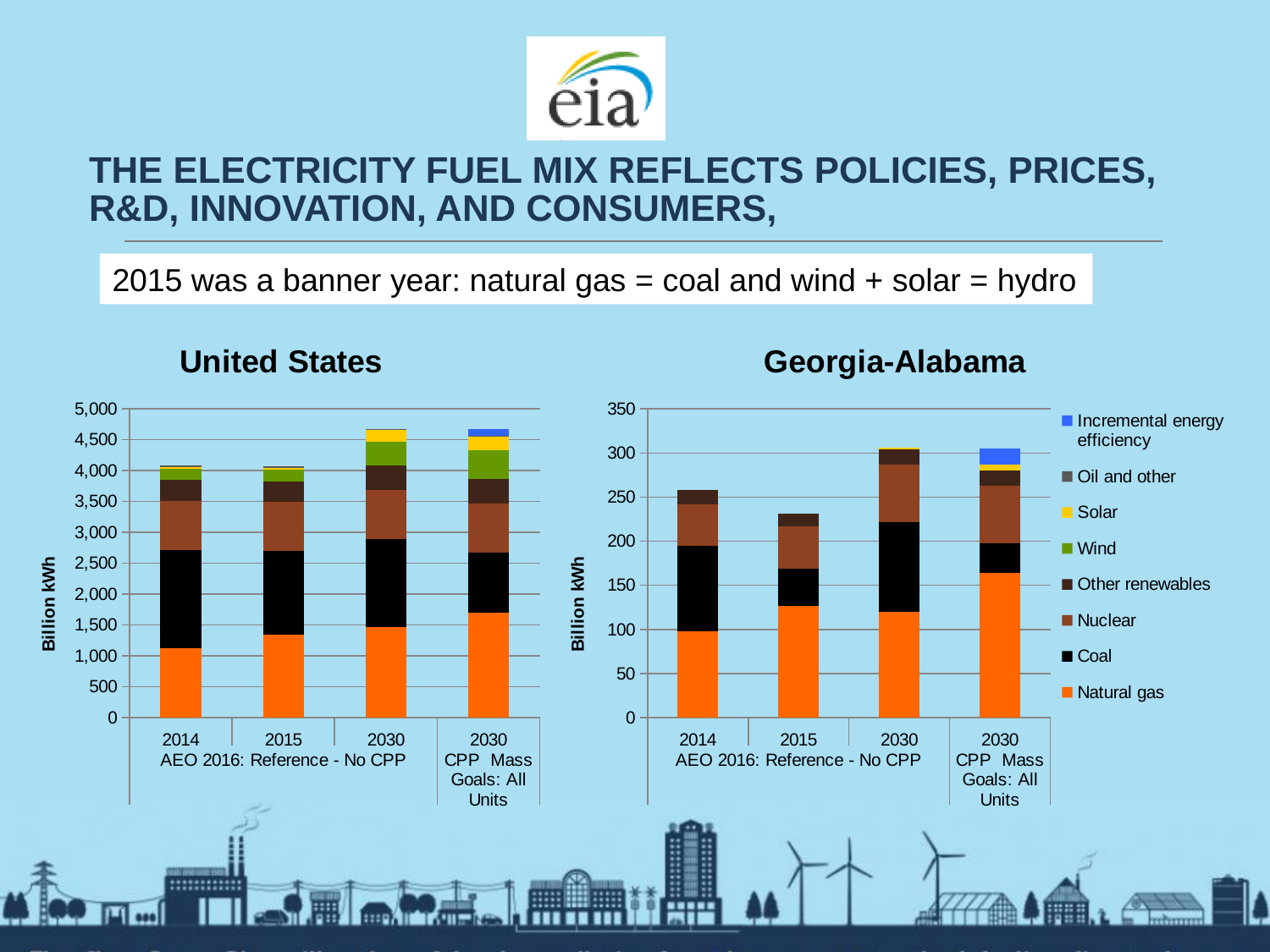
In the legend, which colour represents Natural gas? orange In the United States chart, is the Natural gas value for 2014 greater or less than 1,000? greater In the United States chart, which bar has the smallest Natural gas segment? 2014 In the Georgia-Alabama chart, is the Natural gas value for 2030 CPP Mass Goals: All Units greater or less than 150? greater In the Georgia-Alabama chart, which bar has the largest Natural gas segment? 2030 CPP Mass Goals: All Units In the United States chart, is the total height of the 2030 AEO 2016 Reference - No CPP bar greater or less than 4,500? greater How many series does the legend on the slide list? 8 In the Georgia-Alabama chart, is the Coal segment larger in 2014 or in 2030 CPP Mass Goals: All Units? 2014 What kind of chart is the United States chart? stacked bar chart How many bars does the Georgia-Alabama chart show? 4 What is the y-axis label on the United States chart? Billion kWh